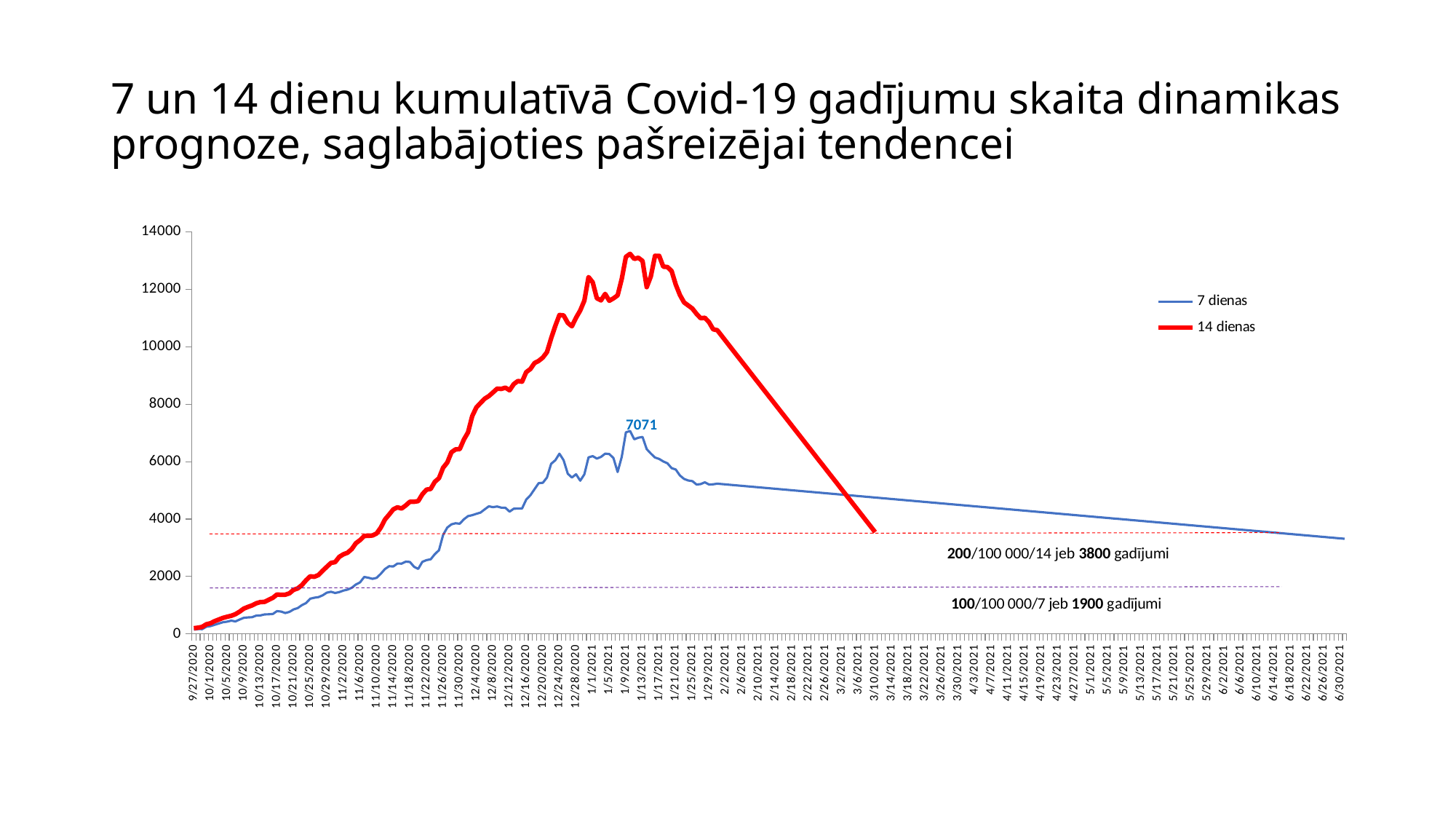
What colour is the 14 dienas line? red Is the value of the 7 dienas line at 11/30/2020 greater or less than 2000? greater How many series does the legend list? 2 Which series reaches the higher peak, 7 dienas or 14 dienas? 14 dienas Is the peak value of the 14 dienas line greater or less than 12000? greater Is the value of the 14 dienas line at 12/24/2020 greater or less than 10000? greater After mid-January 2021, does the 14 dienas line rise or fall along the x axis? fall What is the peak value labelled on the 7 dienas line? 7071 What type of chart is shown on the slide? line chart What are the two series named in the legend? 7 dienas, 14 dienas